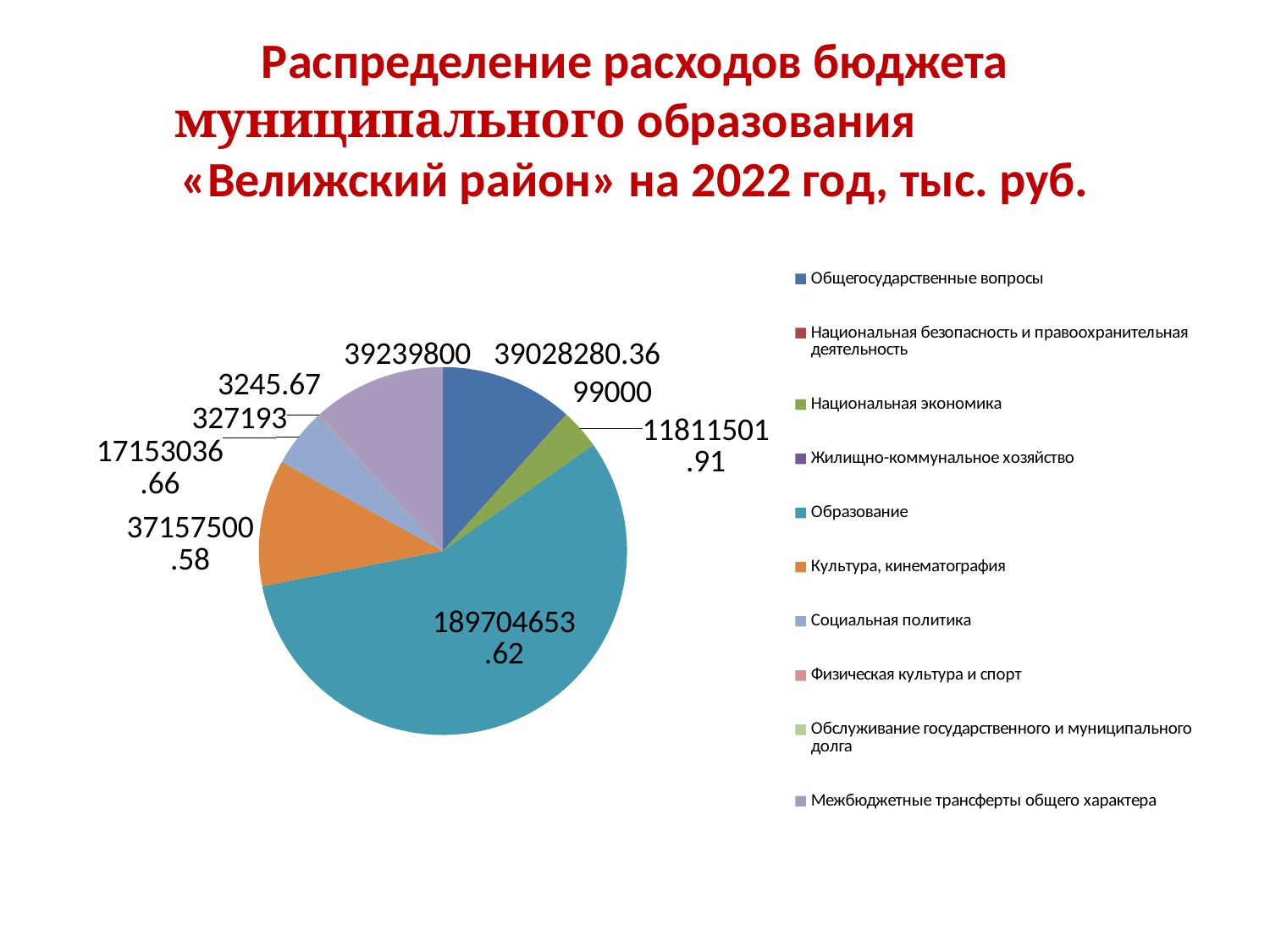
What is the value shown for Общегосударственные вопросы? 39028280.36 For which year does the chart show the distribution of budget expenditures? 2022 How many categories does the legend of the pie chart list? 10 What is the value shown for Социальная политика? 17153036.66 What is the value shown for Межбюджетные трансферты общего характера? 39239800 What is the value shown for Образование? 189704653.62 What is the value shown for Культура, кинематография? 37157500.58 Which category has the largest slice of the pie chart? Образование Which is larger, the value for Образование or the value for Культура, кинематография? Образование What kind of chart is shown on the slide? pie chart What is the value shown for Национальная экономика? 11811501.91 What is the difference between the value for Культура, кинематография and the value for Социальная политика? 20004463.92